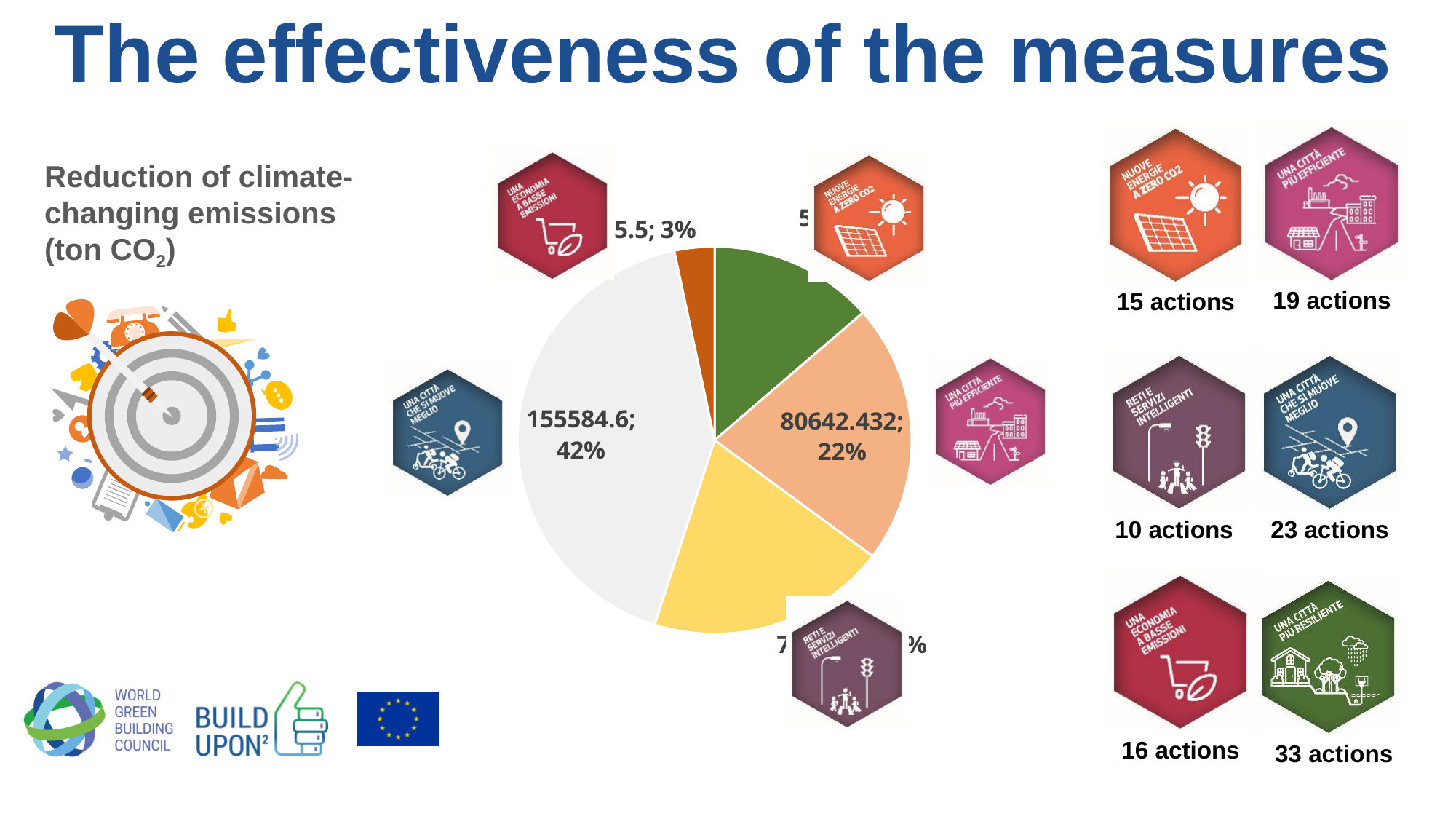
What is the value and share printed on the peach-coloured slice next to the 'Una città più efficiente' hexagon? 80642.432; 22% How many slices does the pie chart have? 5 What share of the pie does the grey slice represent? 42% What is the value and share printed on the largest (grey) slice of the pie chart? 155584.6; 42% What is the difference in percentage points between the 42% slice and the 22% slice? 20 percentage points Which slice of the pie chart is the largest? The grey slice (Una città che si muove meglio), 42% What share of the pie does the slice next to the 'Una economia a basse emissioni' hexagon represent? 3% What does the text to the left of the pie chart say the chart measures? Reduction of climate-changing emissions (ton CO2) Which is larger: the grey slice or the peach-coloured slice? The grey slice What colour is the largest slice of the pie chart? Grey What kind of chart is shown on the slide? Pie chart Which slice of the pie chart is the smallest? The small orange slice (Una economia a basse emissioni), 3%